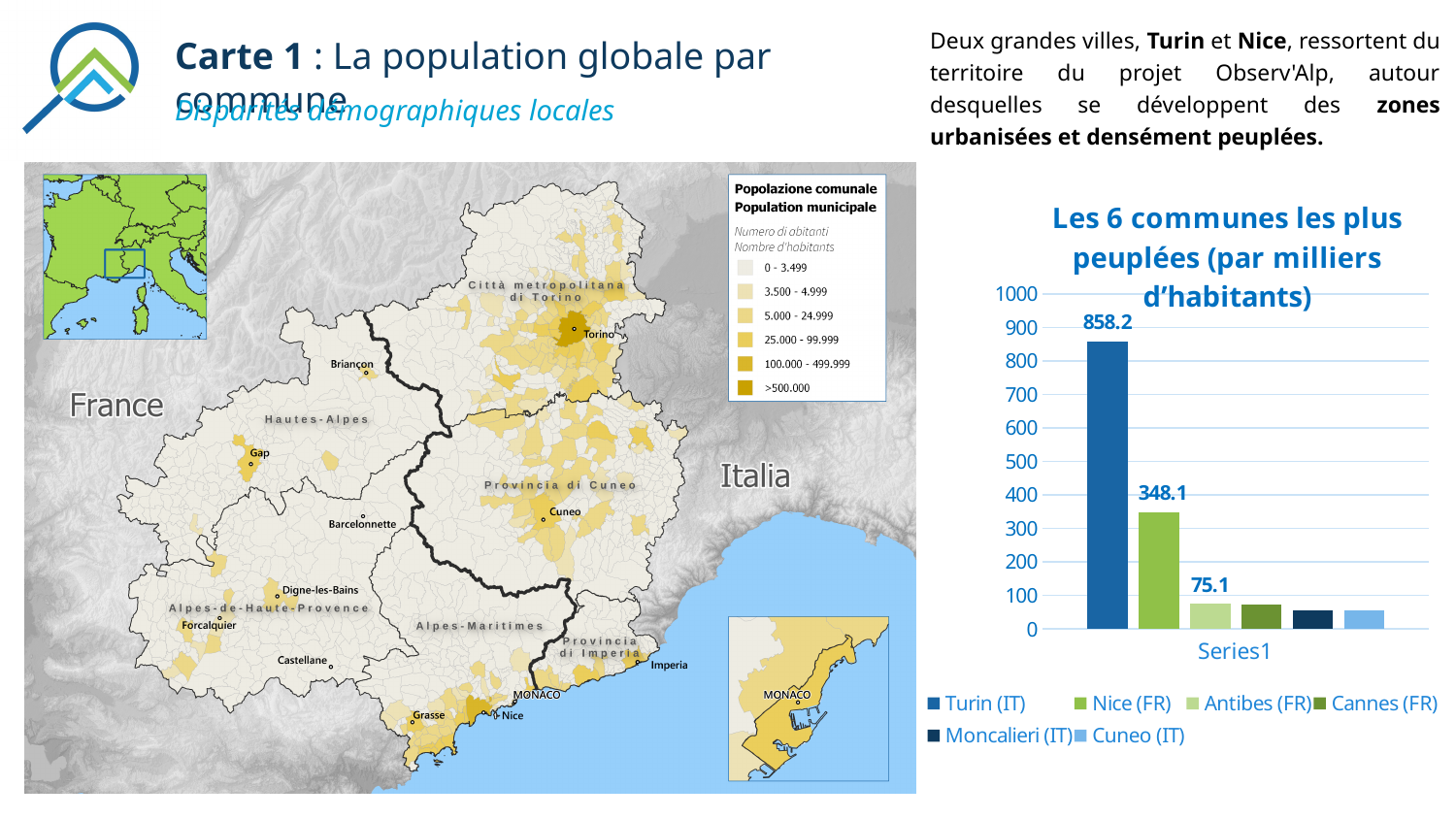
What is the value for Nice (FR) in the bar chart? 348.1 What is the value for Antibes (FR) in the bar chart? 75.1 What is the value for Turin (IT) in the bar chart? 858.2 How many bars are plotted in the bar chart? 6 Which is larger in the bar chart, the value for Nice (FR) or the value for Antibes (FR)? Nice (FR) Is the value for Moncalieri (IT) in the bar chart greater or less than 100? less How many entries does the legend of the bar chart list? 6 Which commune has the highest value in the bar chart? Turin (IT) What is the title of the bar chart? Les 6 communes les plus peuplées (par milliers d'habitants) Is the value for Cannes (FR) in the bar chart greater or less than 100? less What kind of chart is shown on the right of the slide? Bar chart What is the difference between the values for Turin (IT) and Nice (FR) in the bar chart? 510.1